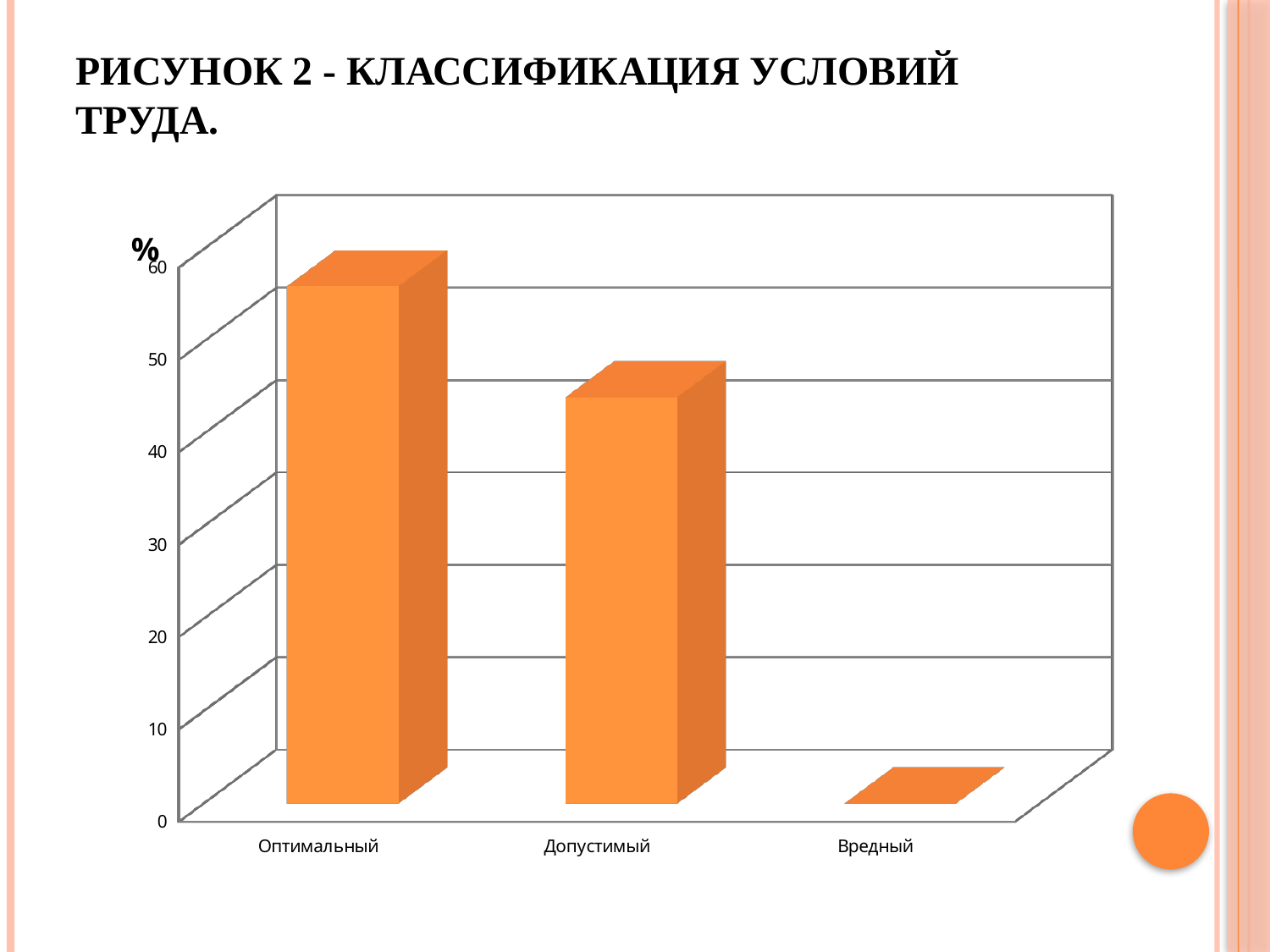
Which category has the highest value in the chart? Оптимальный Is the value for Допустимый greater or less than 50? less Is the value for Вредный greater or less than 10? less Do the values rise or fall moving from left to right along the x axis? fall What is the title of the slide containing the chart? РИСУНОК 2 - КЛАССИФИКАЦИЯ УСЛОВИЙ ТРУДА. Which is larger, the value for Оптимальный or the value for Допустимый? Оптимальный Is the value for Допустимый greater or less than 40? greater What unit is shown on the vertical axis of the chart? % What kind of chart is shown on the slide? bar chart How many categories are shown on the x axis of the chart? 3 Which category has the lowest value in the chart? Вредный